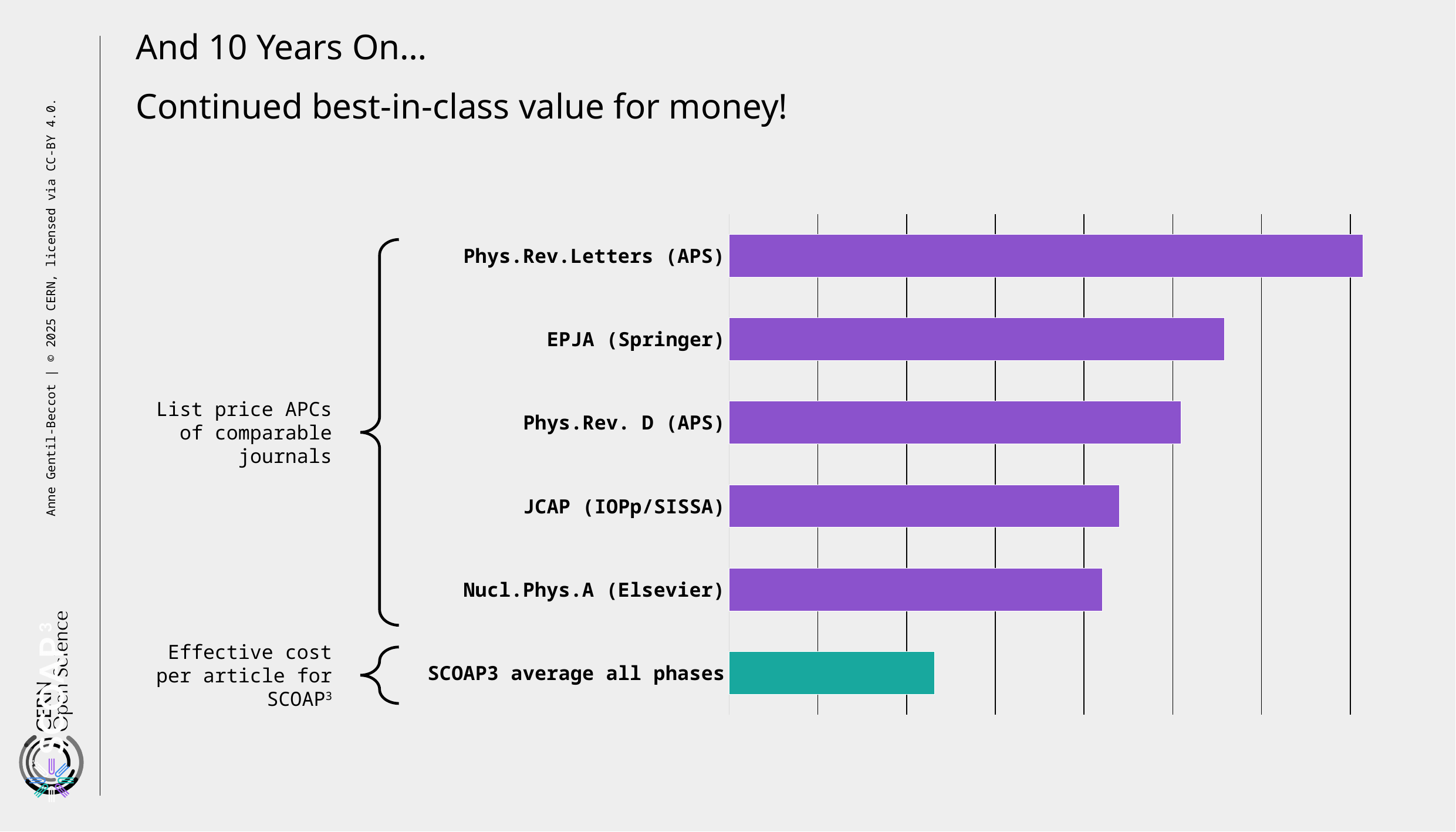
Which bar is coloured differently from the others? SCOAP3 average all phases Which is larger, the value for EPJA (Springer) or the value for Phys.Rev. D (APS)? EPJA (Springer) Which category has the longest bar? Phys.Rev.Letters (APS) What colour are the bars for the comparable journals' list price APCs? purple Which is larger, the value for Phys.Rev. D (APS) or the value for SCOAP3 average all phases? Phys.Rev. D (APS) What kind of chart is shown on the slide? bar chart Do the bar lengths increase or decrease going from the top bar to the bottom bar? decrease How many bars does the chart show? 6 Which category has the shortest bar? SCOAP3 average all phases Which is larger, the value for Nucl.Phys.A (Elsevier) or the value for SCOAP3 average all phases? Nucl.Phys.A (Elsevier)